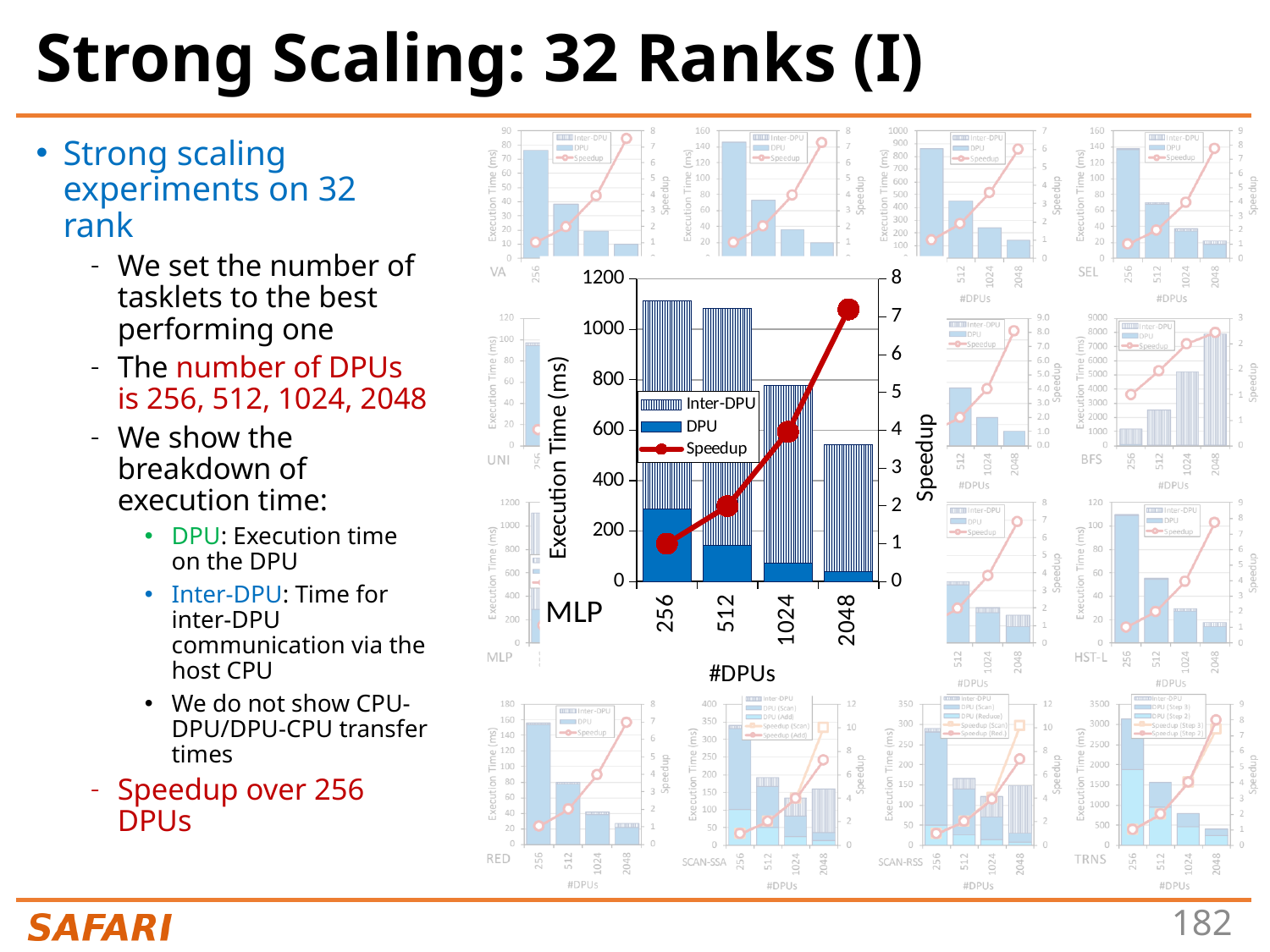
In the large MLP chart, is the total execution time bar for 512 DPUs larger or smaller than the bar for 1024 DPUs? larger In the large MLP chart, which #DPUs category has the tallest total execution time bar? 256 What kind of chart is the large MLP chart? bar chart (stacked bars with a speedup line) In the large MLP chart, what is the label of the x axis? #DPUs In the large MLP chart, how many #DPUs categories are shown on the x axis? 4 In the large MLP chart, is the total execution time for 2048 DPUs greater or less than 600? less In the large MLP chart, does the total execution time rise or fall as the number of DPUs increases? fall In the large MLP chart, is the Speedup for 2048 DPUs greater or less than 6? greater In the large MLP chart, how many series does the legend list? 3 In the large MLP chart, which #DPUs category has the shortest total execution time bar? 2048 In the large MLP chart, is the total execution time for 256 DPUs greater or less than 1000? greater In the large MLP chart, which #DPUs category has the highest Speedup? 2048